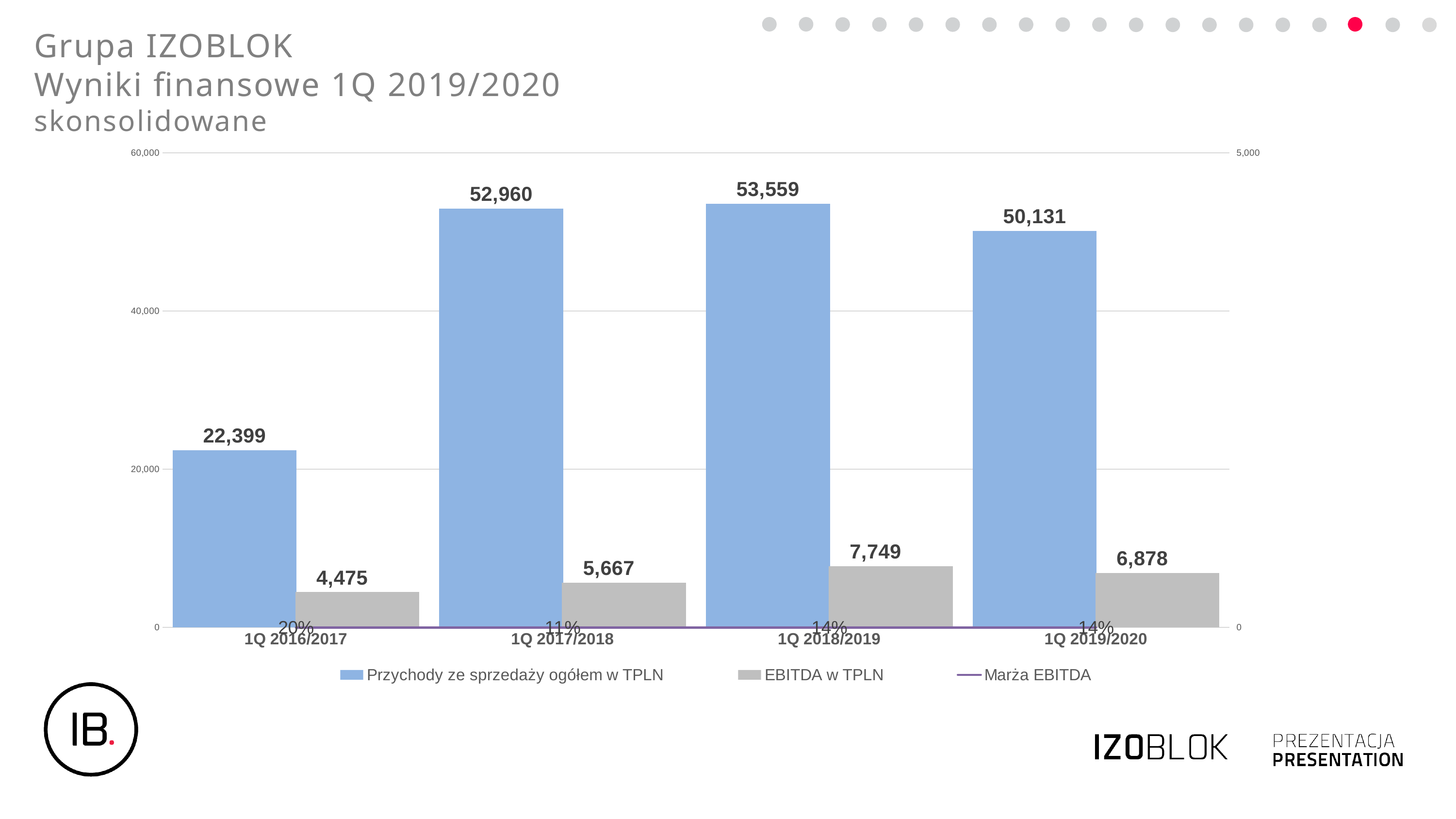
Which is larger: Przychody ze sprzedaży ogółem w TPLN in 1Q 2017/2018 or in 1Q 2019/2020? 1Q 2017/2018 What is the EBITDA w TPLN value for 1Q 2018/2019? 7,749 Which quarter has the highest Przychody ze sprzedaży ogółem w TPLN? 1Q 2018/2019 How many series does the legend list? 3 Which quarter has the lowest EBITDA w TPLN? 1Q 2016/2017 What is the value of Przychody ze sprzedaży ogółem w TPLN for 1Q 2019/2020? 50,131 Is the Przychody ze sprzedaży ogółem w TPLN value for 1Q 2016/2017 greater or less than 40,000? less What is the difference between EBITDA w TPLN in 1Q 2018/2019 and 1Q 2019/2020? 871 How many quarters are shown on the x axis? 4 What is the Marża EBITDA for 1Q 2016/2017? 20% Did Przychody ze sprzedaży ogółem w TPLN rise or fall from 1Q 2018/2019 to 1Q 2019/2020? fall What kind of chart is shown on the slide? Bar chart with a line